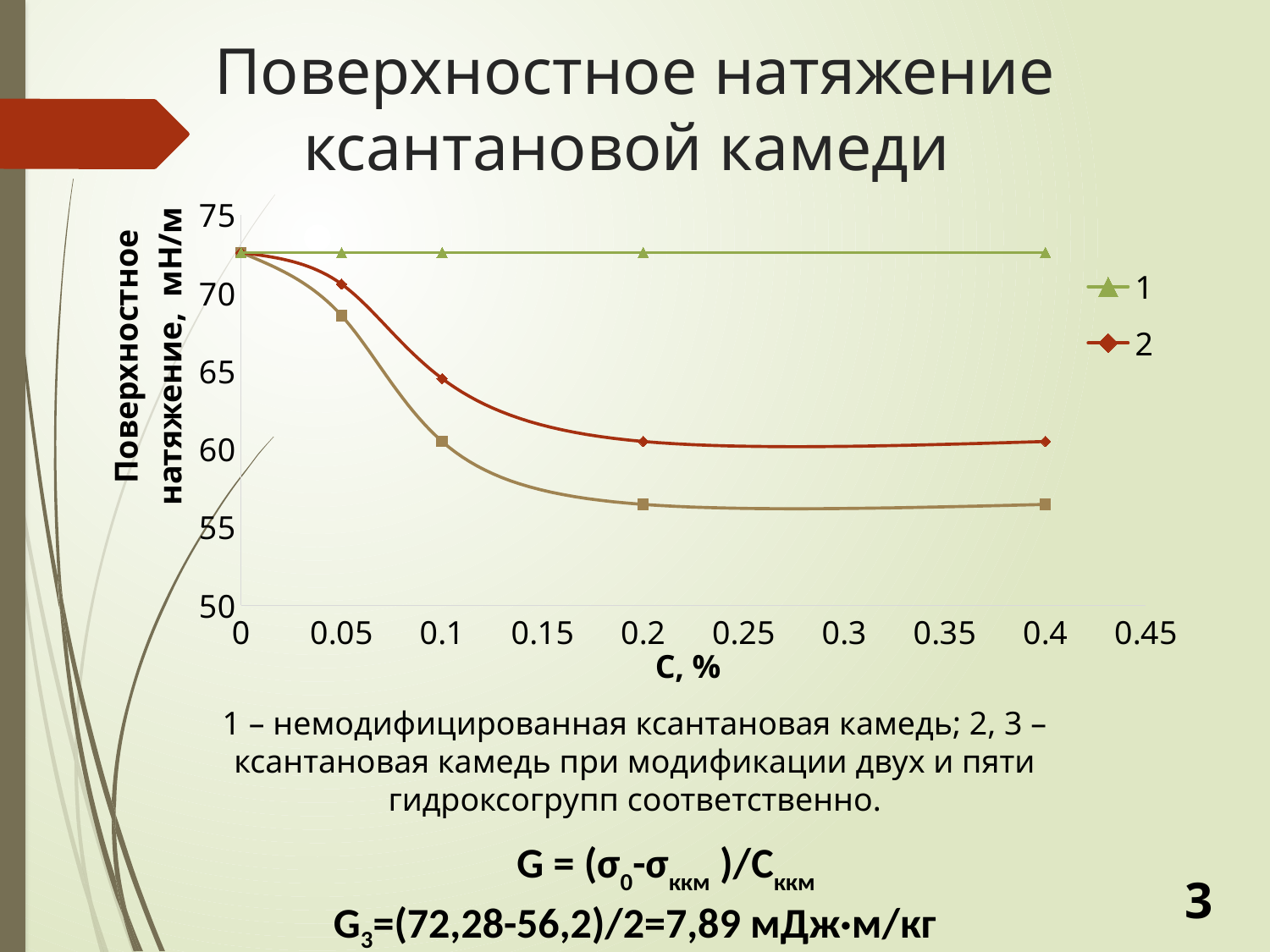
Is the value for series 2 at C = 0.1 greater or less than 70? less How many data points are plotted for series 2? 5 What is the label of the x axis? C, % At C = 0.1, which series has the larger value, series 1 or series 2? series 1 Does the value of series 2 rise or fall as C increases from 0 to 0.2? fall What is the title of the chart on the slide? Поверхностное натяжение ксантановой камеди Is the value for series 2 at C = 0.4 greater or less than 65? less How many series does the chart legend list? 2 Does series 1 rise, fall or stay roughly constant as C increases? stays roughly constant Which legend series has the highest value at C = 0.4? 1 Is the value for series 1 at C = 0.2 greater or less than 70? greater What kind of chart is shown on the slide? line chart